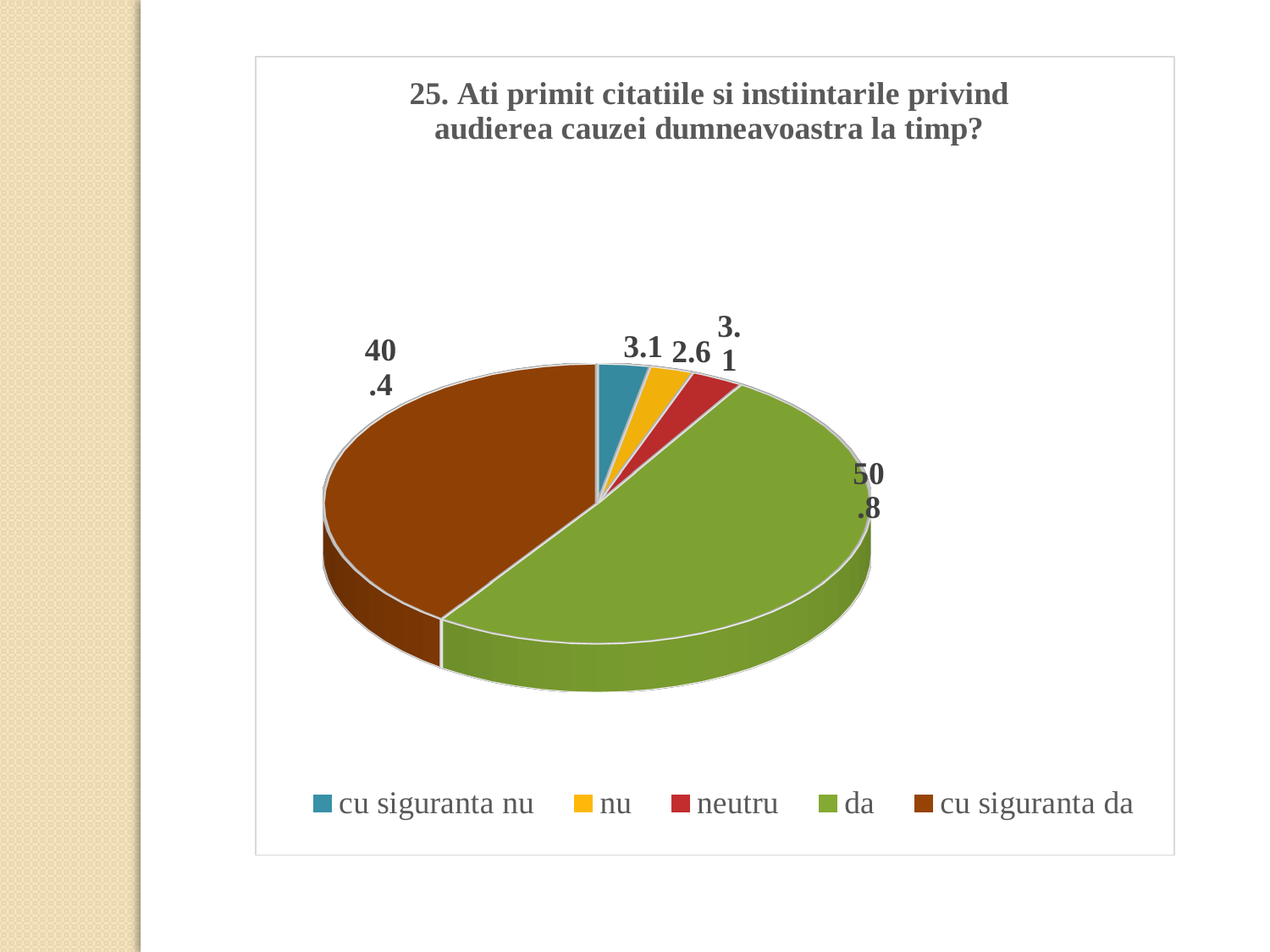
What is the value for "da" in the pie chart? 50.8 What kind of chart is shown on the slide? Pie chart What is the difference between the values for "da" and "cu siguranta da"? 10.4 What colour is the slice for "cu siguranta da"? Brown What is the value for "nu" in the pie chart? 2.6 Which category has the largest slice of the pie chart? da What is the value for "cu siguranta nu" in the pie chart? 3.1 Which category has the smallest slice of the pie chart? nu What is the value for "cu siguranta da" in the pie chart? 40.4 How many categories are shown in the pie chart? 5 Which is larger, the value for "cu siguranta da" or the value for "da"? da What is the value for "neutru" in the pie chart? 3.1